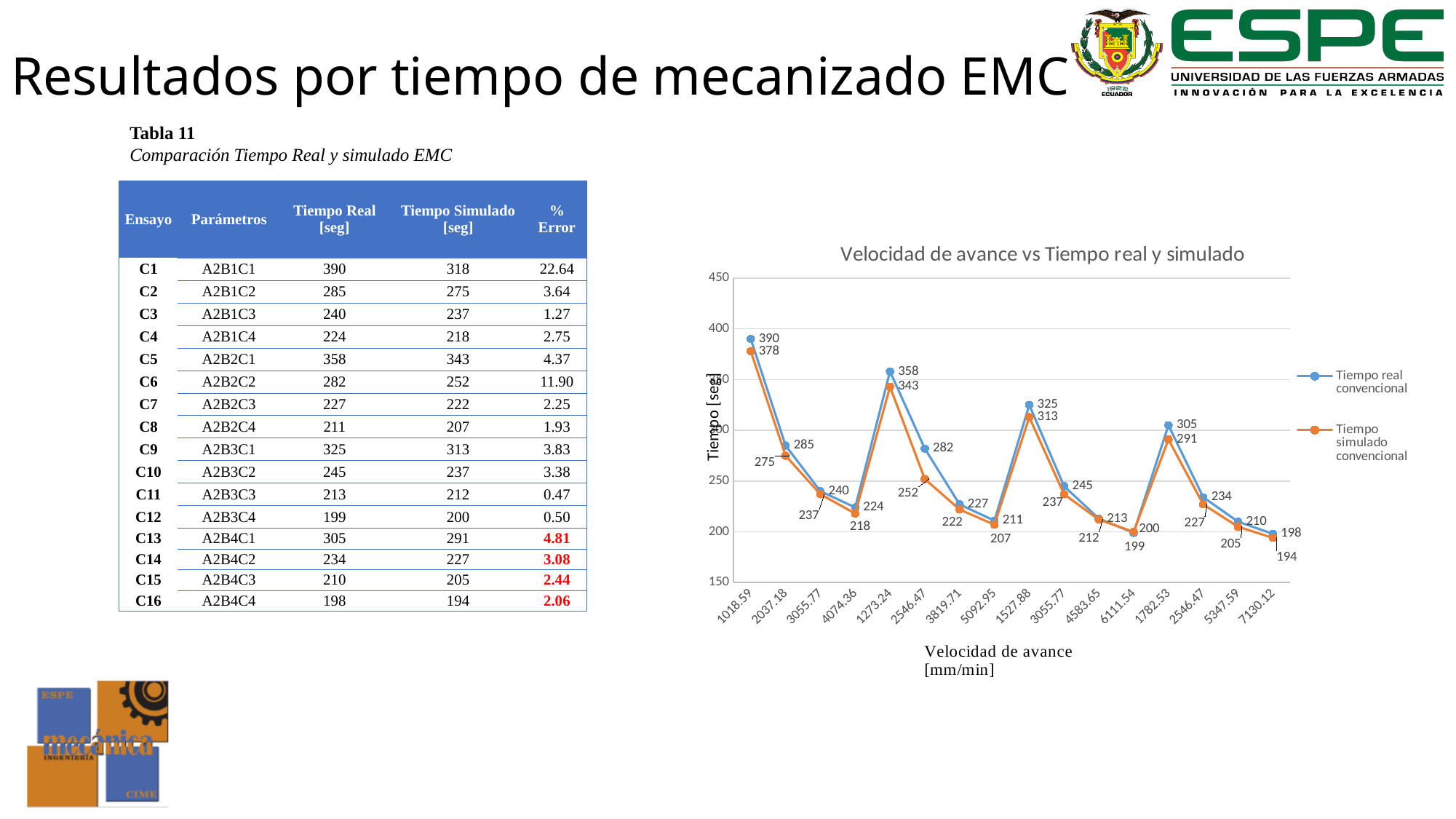
What kind of chart is shown on the slide? line chart At which velocidad de avance does Tiempo real convencional reach its highest value? 1018.59 How many series does the legend of the chart list? 2 What is the value of Tiempo real convencional at a velocidad de avance of 1018.59? 390 How many data points does each series in the chart have? 16 What is the title of the vertical axis of the chart? Tiempo [seg] At a velocidad de avance of 1527.88, what is the difference between Tiempo real convencional and Tiempo simulado convencional? 12 At which velocidad de avance does Tiempo simulado convencional reach its lowest value? 7130.12 At a velocidad de avance of 4074.36, which series has the larger value? Tiempo real convencional What is the value of Tiempo simulado convencional at a velocidad de avance of 5092.95? 207 What is the value of Tiempo simulado convencional at a velocidad de avance of 1273.24? 343 What is the value of Tiempo real convencional at a velocidad de avance of 6111.54? 199